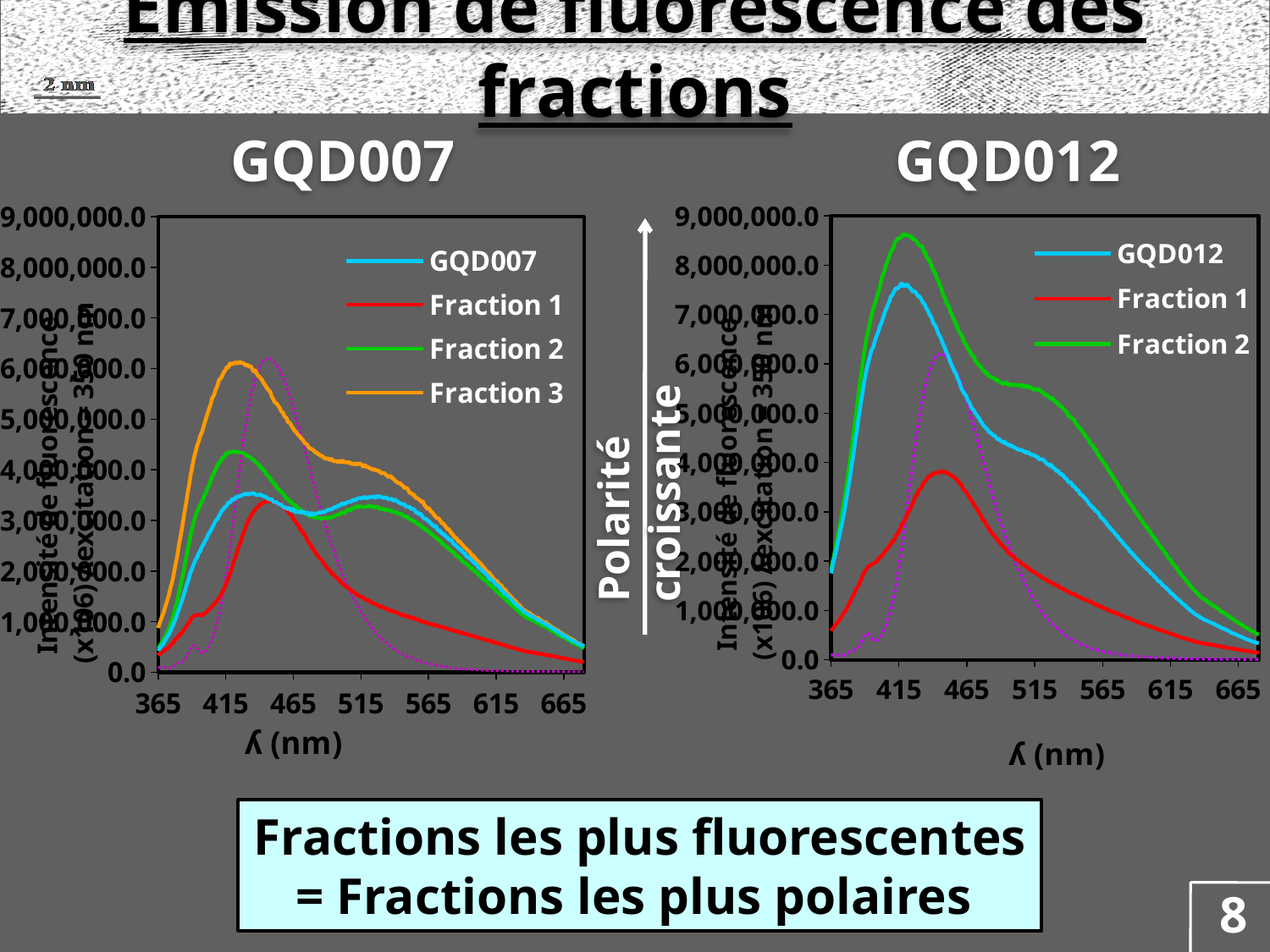
In the GQD012 chart, is the peak value of Fraction 1 greater or less than 5,000,000.0? less In the GQD007 chart, which has the higher peak intensity, Fraction 2 or Fraction 1? Fraction 2 In the GQD007 chart, is the peak value of Fraction 3 greater or less than 5,000,000.0? greater In the GQD007 chart, which series reaches the highest fluorescence intensity? Fraction 3 What is the x-axis label of the GQD012 chart? ʎ (nm) In the GQD007 chart, which series has the lowest peak intensity? Fraction 1 What kind of chart is the GQD007 chart on the left? line chart How many series does the legend of the GQD012 chart list? 3 In the GQD012 chart, do the curves rise or fall between 565 nm and 665 nm? fall How many series does the legend of the GQD007 chart list? 4 In the GQD012 chart, which series reaches the highest fluorescence intensity? Fraction 2 In the GQD012 chart, is the peak value of Fraction 2 greater or less than 8,000,000.0? greater